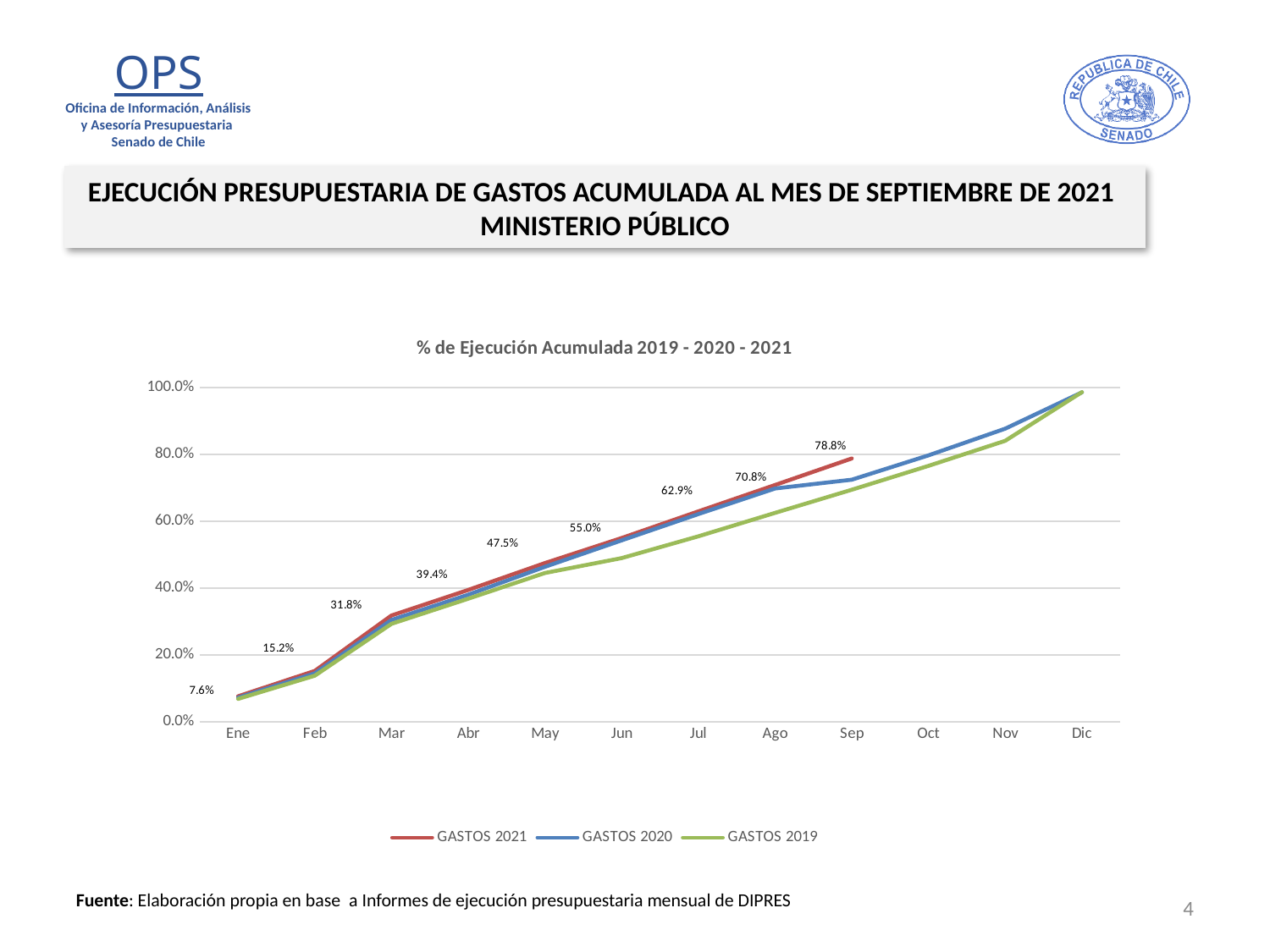
How many months are shown on the x axis? 12 Do the GASTOS 2021 values rise or fall from Ene to Sep? Rise What is the value of GASTOS 2021 in Ene? 7.6% Is the value for GASTOS 2020 in Nov greater or less than 80.0%? greater What is the value of GASTOS 2021 in Mar? 31.8% Is the value for GASTOS 2019 in Jun greater or less than 60.0%? less What is the difference between the GASTOS 2021 values for Feb and Ene? 7.6% What is the difference between the GASTOS 2021 values for Sep and Ago? 8.0% What kind of chart is shown on the slide? Line chart How many series does the legend list? 3 What is the value of GASTOS 2021 in Jun? 55.0% What is the value of GASTOS 2021 in Sep? 78.8%